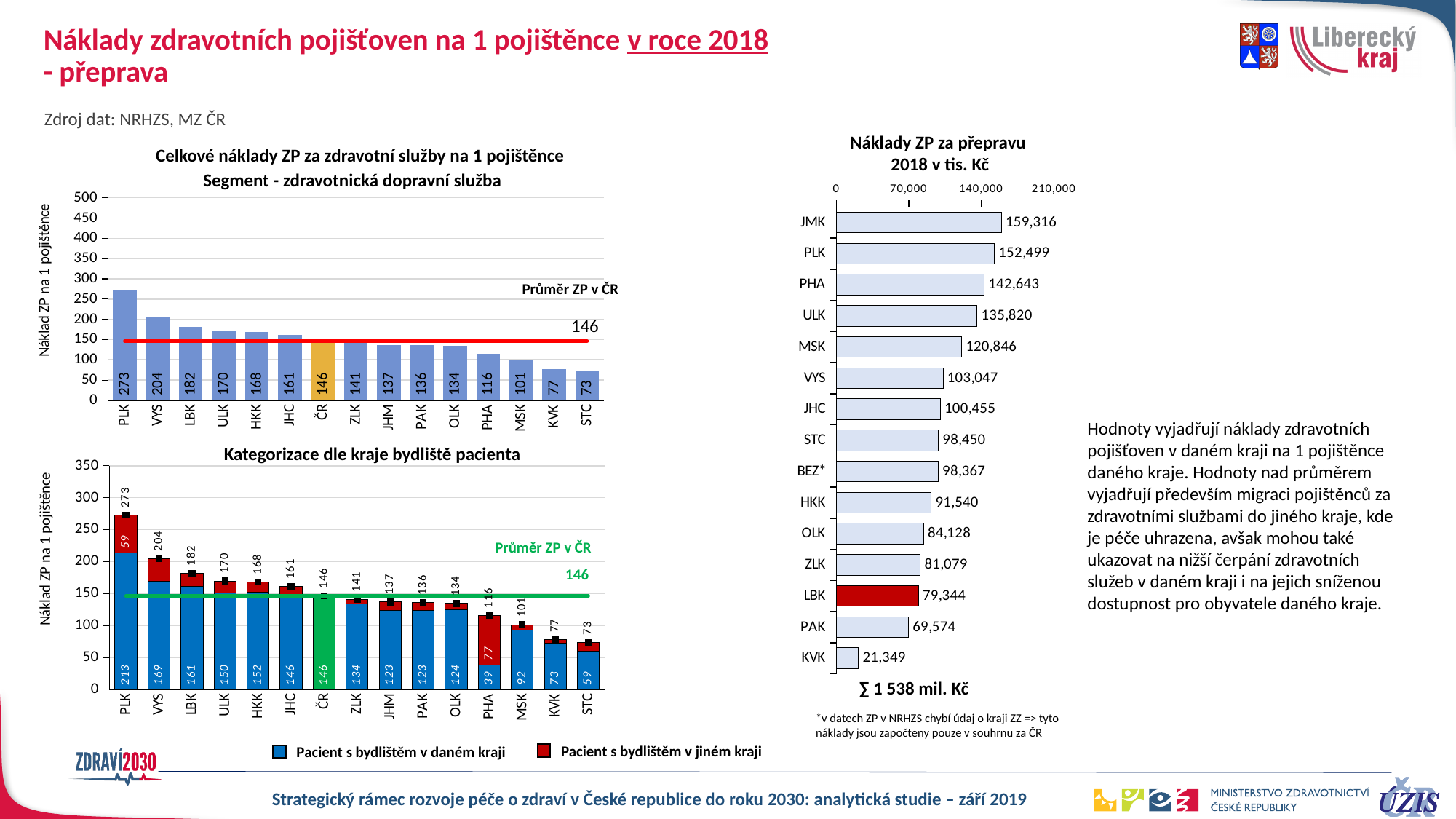
In the top-left chart 'Celkové náklady ZP za zdravotní služby na 1 pojištěnce', how many bars are plotted? 15 In the bottom-left chart 'Kategorizace dle kraje bydliště pacienta', what is the total of the stacked bar for PLK? 273 In the right chart 'Náklady ZP za přepravu 2018 v tis. Kč', which region has the highest value? JMK In the right chart 'Náklady ZP za přepravu 2018 v tis. Kč', what is the difference between the values for LBK and KVK? 57,995 In the bottom-left chart 'Kategorizace dle kraje bydliště pacienta', what kind of chart is it? Stacked bar chart In the top-left chart 'Celkové náklady ZP za zdravotní služby na 1 pojištěnce', what is the value for PLK? 273 In the top-left chart 'Celkové náklady ZP za zdravotní služby na 1 pojištěnce', what is the difference between the values for PLK and VYS? 69 In the bottom-left chart 'Kategorizace dle kraje bydliště pacienta', what is the value of the 'Pacient s bydlištěm v daném kraji' segment for PHA? 39 In the bottom-left chart 'Kategorizace dle kraje bydliště pacienta', how many series does the legend list? 2 In the right chart 'Náklady ZP za přepravu 2018 v tis. Kč', what is the value for LBK? 79,344 In the top-left chart 'Celkové náklady ZP za zdravotní služby na 1 pojištěnce', which region has the lowest value? STC In the top-left chart 'Celkové náklady ZP za zdravotní služby na 1 pojištěnce', what is the value of the 'Průměr ZP v ČR' line? 146